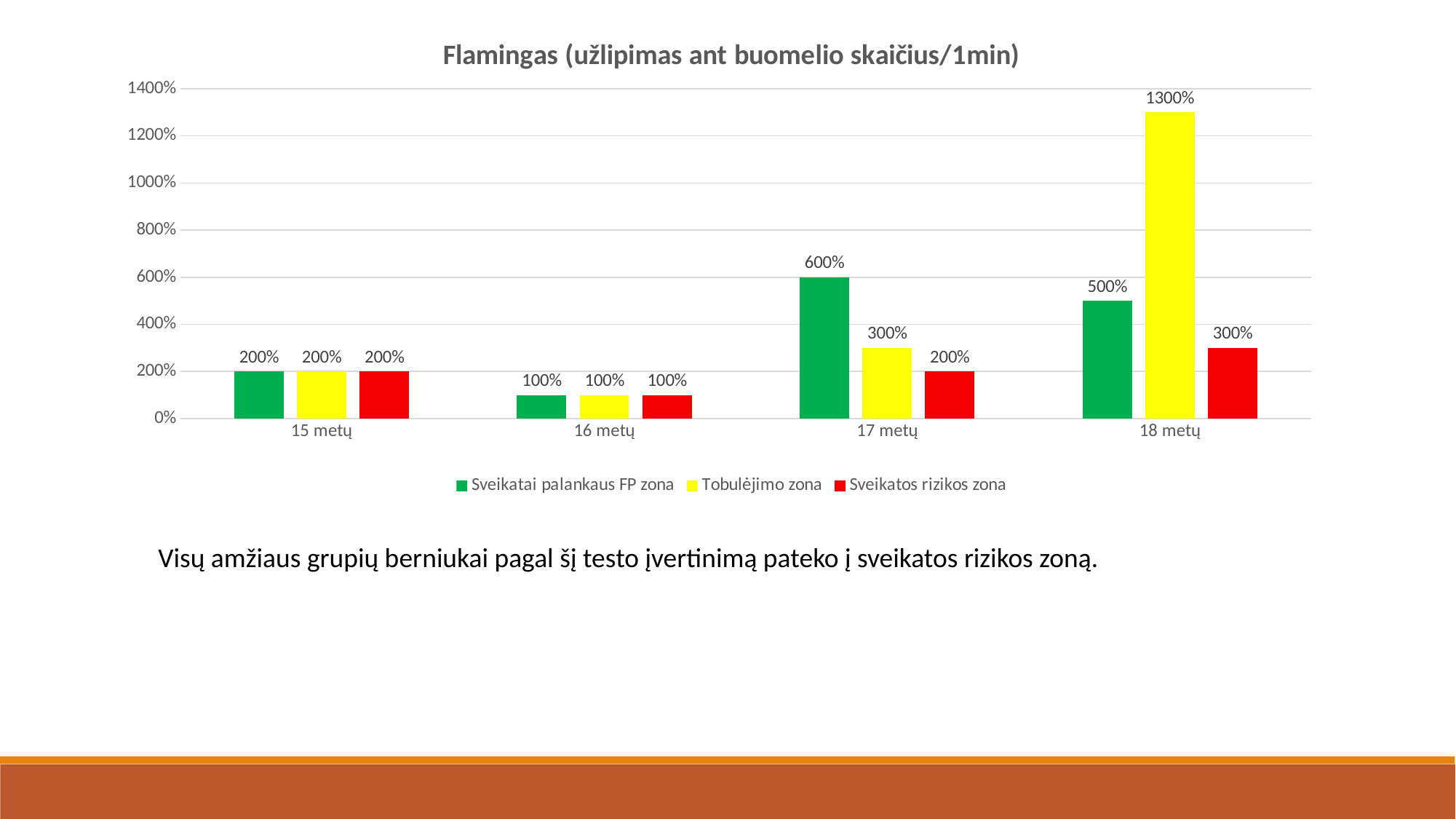
Which colour represents Sveikatos rizikos zona in the chart? Red What is the value of Sveikatai palankaus FP zona for 17 metų? 600% What is the value of Sveikatos rizikos zona for 16 metų? 100% How many age groups are shown on the x axis? 4 How many series does the legend list? 3 What is the value of Tobulėjimo zona for 18 metų? 1300% What is the title of the chart? Flamingas (užlipimas ant buomelio skaičius/1min) What is the difference between the Tobulėjimo zona value and the Sveikatos rizikos zona value for 18 metų? 1000% Which is larger for 17 metų: Sveikatai palankaus FP zona or Tobulėjimo zona? Sveikatai palankaus FP zona Which age group has the lowest value for Sveikatai palankaus FP zona? 16 metų What kind of chart is shown on the slide? Bar chart Which age group has the highest value for Tobulėjimo zona? 18 metų